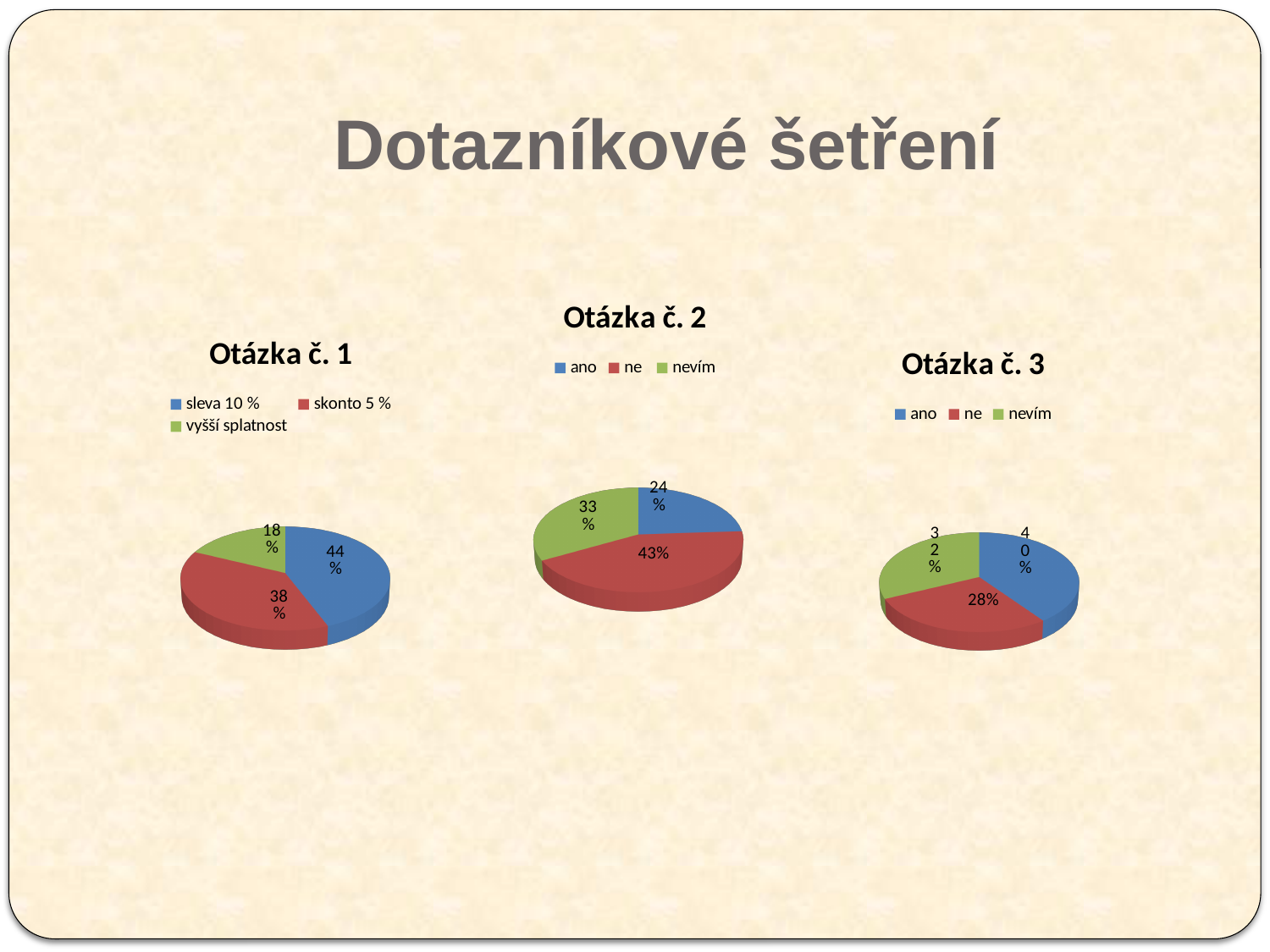
In the chart titled "Otázka č. 1", what is the difference between the shares of "sleva 10 %" and "skonto 5 %"? 6% In the chart titled "Otázka č. 1", what share does "sleva 10 %" have? 44% In the chart titled "Otázka č. 1", what share does "vyšší splatnost" have? 18% In the chart titled "Otázka č. 2", which category has the smallest slice? ano In the chart titled "Otázka č. 3", what is the difference between the shares of "ano" and "ne"? 12% In the chart titled "Otázka č. 2", which is larger, "nevím" or "ano"? nevím In the chart titled "Otázka č. 3", what share does "ano" have? 40% What kind of chart is the chart titled "Otázka č. 2"? pie chart In the chart titled "Otázka č. 1", which category has the largest slice? sleva 10 % In the chart titled "Otázka č. 2", what share does "ne" have? 43% In the chart titled "Otázka č. 3", what share does "ne" have? 28% How many slices does the chart titled "Otázka č. 3" have? 3